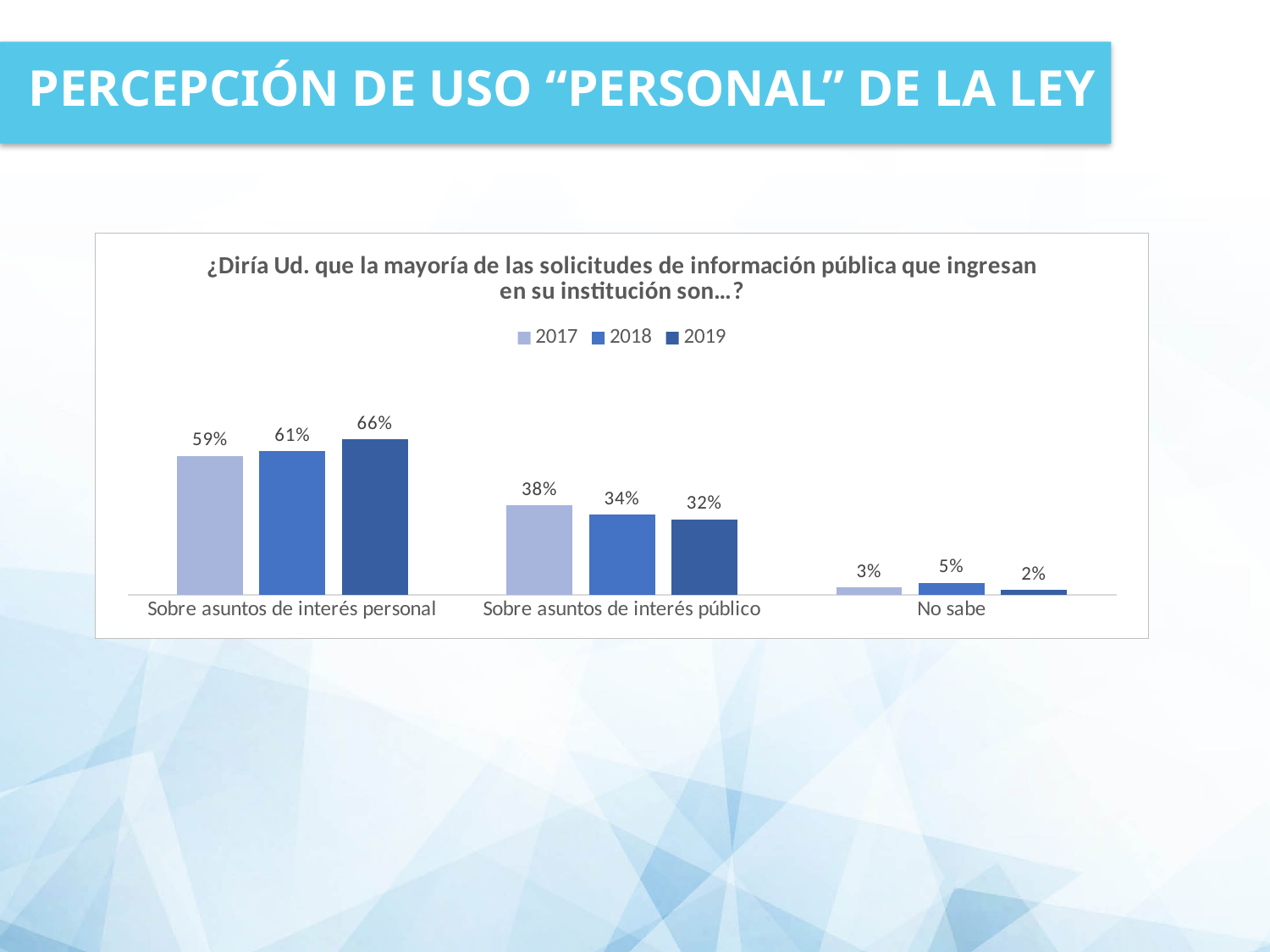
What is the value for 2017 in the 'Sobre asuntos de interés público' category? 38% Which years are listed in the chart legend? 2017, 2018, 2019 How many categories are shown on the x axis? 3 What is the value for 2019 in the 'Sobre asuntos de interés personal' category? 66% What is the value for 2018 in the 'No sabe' category? 5% Do the values for 'Sobre asuntos de interés público' rise or fall from 2017 to 2019? Fall Which is larger: the 2018 value for 'Sobre asuntos de interés público' or the 2019 value for the same category? 2018 Which category has the lowest value for 2017? No sabe What kind of chart is shown on the slide? Bar chart How many series does the legend list? 3 What is the difference between the 2019 and 2017 values for 'Sobre asuntos de interés personal'? 7 percentage points Which category has the highest value for 2019? Sobre asuntos de interés personal